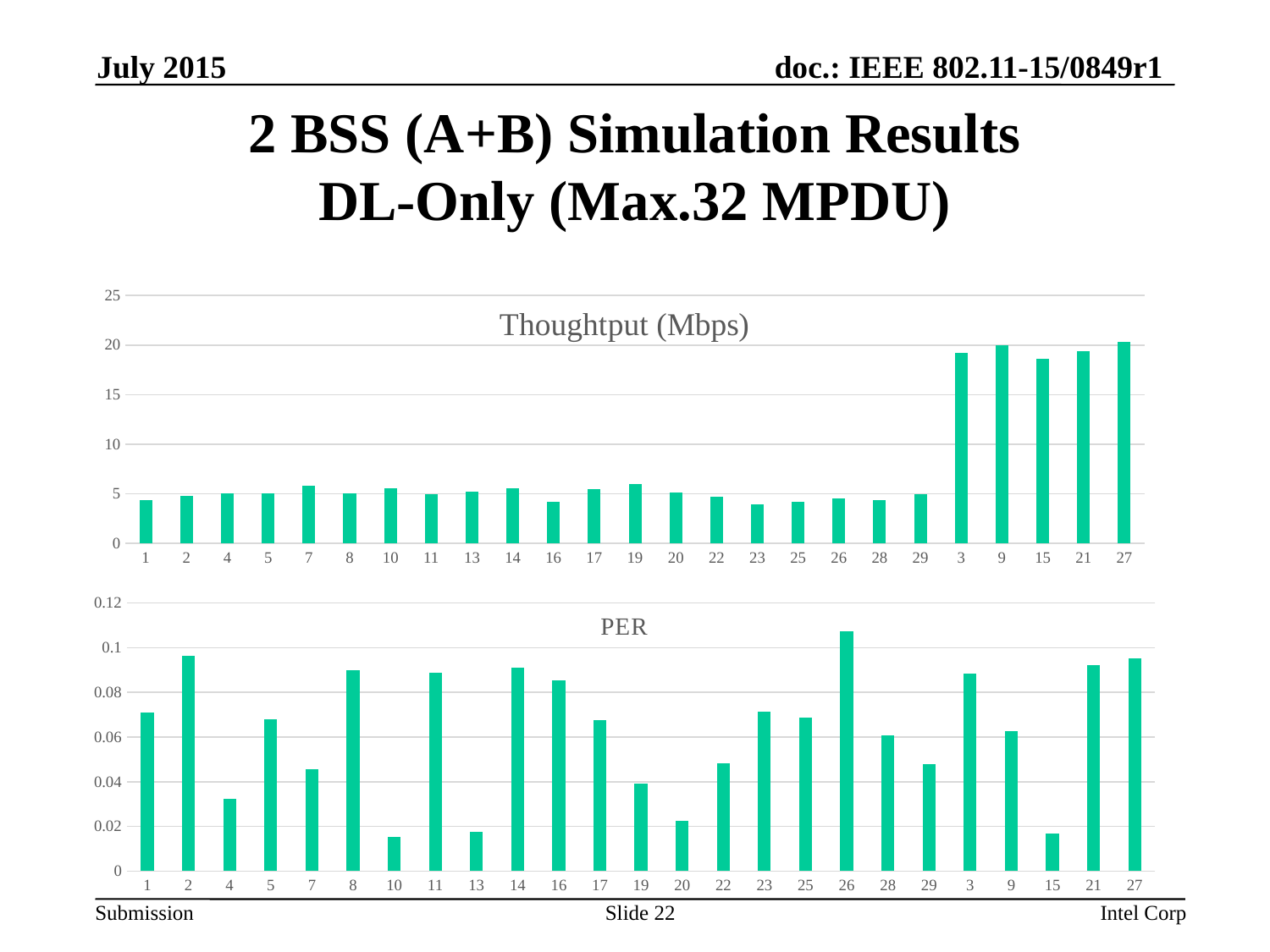
In the "PER" chart, which category has the highest value? 26 What is the title of the top chart on the slide? Thoughtput (Mbps) In the "Thoughtput (Mbps)" chart, is the value for category 19 greater or less than 5? greater In the "Thoughtput (Mbps)" chart, how many categories are shown on the x axis? 25 In the "Thoughtput (Mbps)" chart, is the value for category 1 greater or less than 5? less In the "PER" chart, is the value for category 2 greater or less than 0.08? greater In the "PER" chart, which has the larger value, category 2 or category 4? 2 In the "PER" chart, which has the larger value, category 26 or category 20? 26 In the "Thoughtput (Mbps)" chart, which has the larger value, category 3 or category 1? 3 What kind of chart is the top chart titled "Thoughtput (Mbps)"? bar chart